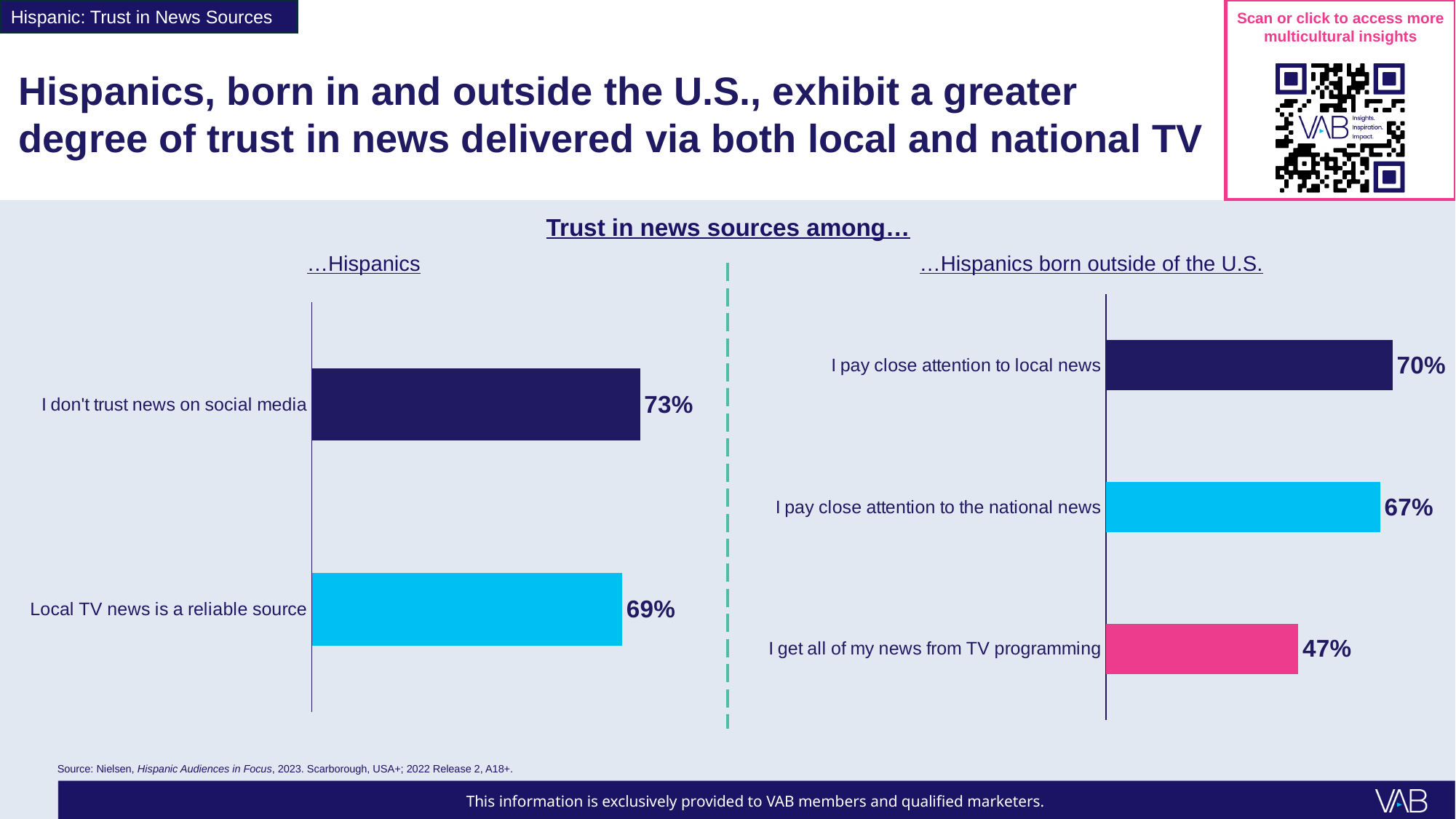
In the right chart (…Hispanics born outside of the U.S.), what is the difference between paying close attention to local news and paying close attention to the national news? 3% In the right chart (…Hispanics born outside of the U.S.), which is larger: paying close attention to the national news or getting all news from TV programming? I pay close attention to the national news In the right chart (…Hispanics born outside of the U.S.), which statement has the highest percentage? I pay close attention to local news In the right chart (…Hispanics born outside of the U.S.), what percentage say they pay close attention to local news? 70% How many statements are shown in the right chart (…Hispanics born outside of the U.S.)? 3 In the left chart (…Hispanics), what is the difference between the percentage who don't trust news on social media and the percentage who say local TV news is a reliable source? 4% In the left chart (…Hispanics), what percentage agree that they don't trust news on social media? 73% In the right chart (…Hispanics born outside of the U.S.), which statement has the lowest percentage? I get all of my news from TV programming In the right chart (…Hispanics born outside of the U.S.), what percentage say they get all of their news from TV programming? 47% What is the overall title shown above the two charts? Trust in news sources among… In the left chart (…Hispanics), what percentage say local TV news is a reliable source? 69% What type of chart is used in the left chart (…Hispanics)? Bar chart